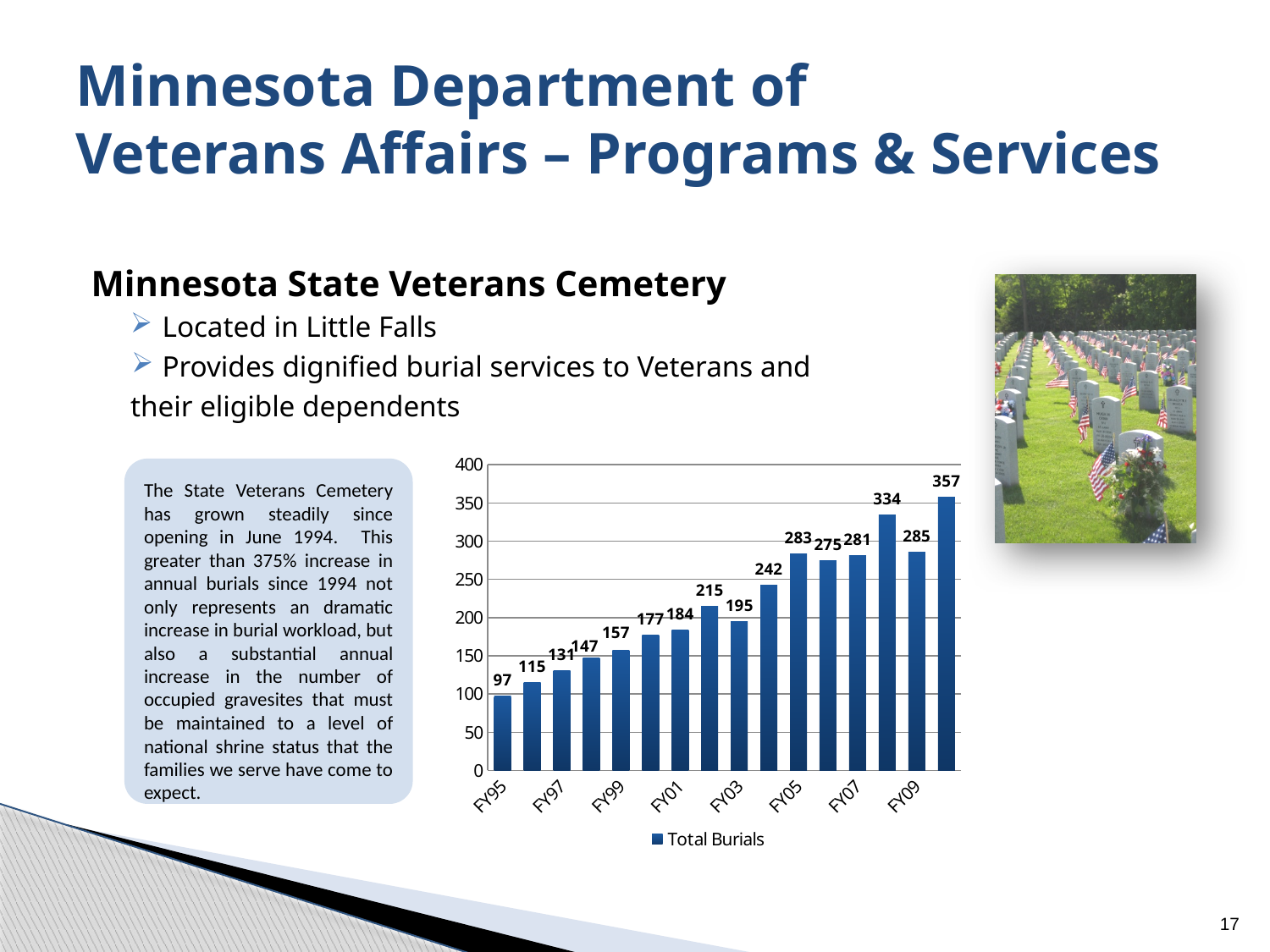
What is the value of Total Burials for FY05? 283 What is the value of Total Burials for FY09? 285 What is the difference in Total Burials between FY09 and FY95? 188 How many series does the chart legend list? 1 What type of chart is shown on the slide? bar chart What is the value of the tallest bar in the chart? 357 Which labeled fiscal year has the lowest Total Burials? FY95 What is the value of Total Burials for FY01? 184 How many bars are plotted in the chart? 16 What is the value of Total Burials for FY95? 97 What is the name of the series shown in the chart legend? Total Burials Which has more Total Burials, FY03 or FY05? FY05